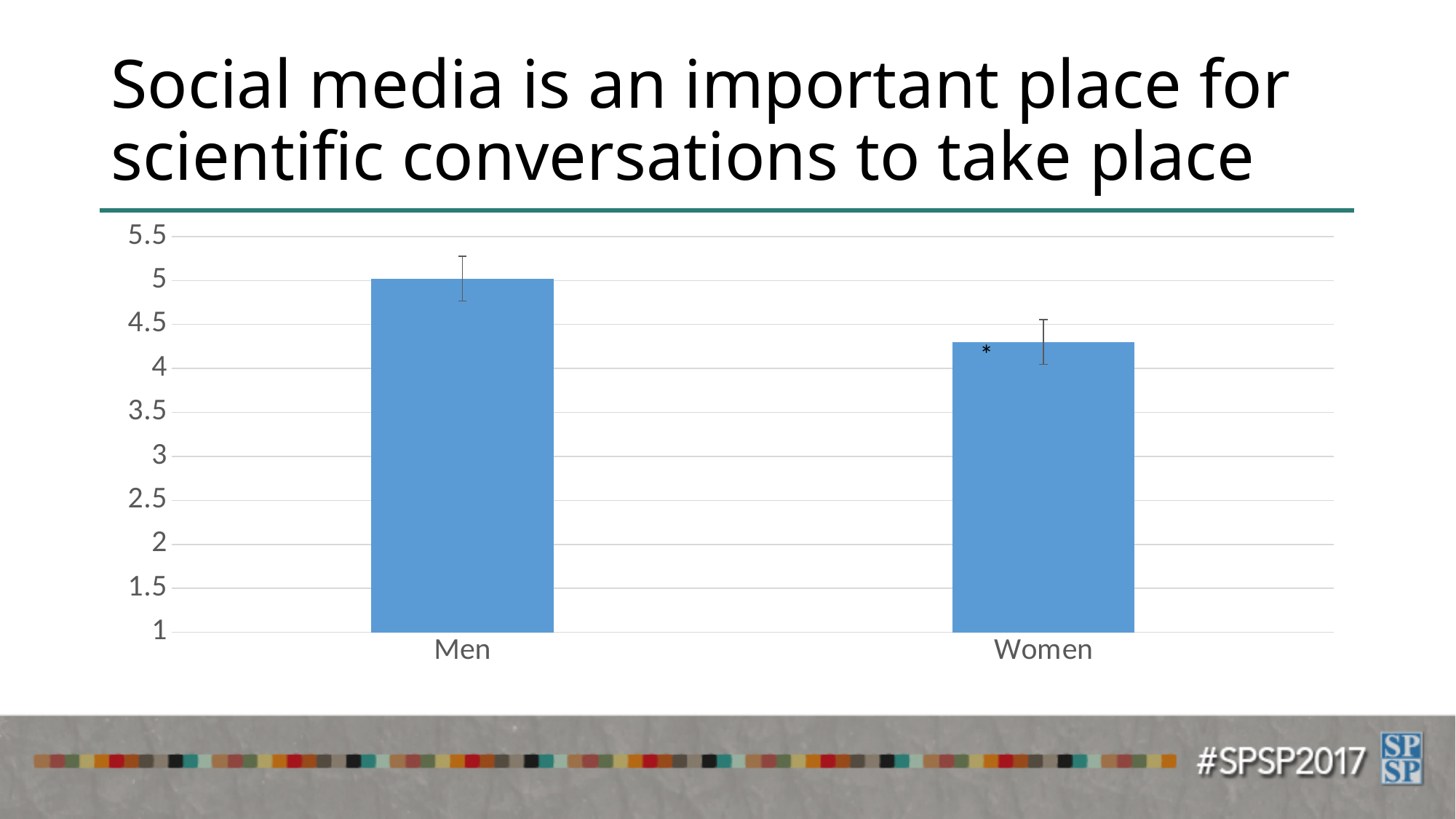
Is the value for Women greater or less than 4? greater Which category has the highest bar? Men What kind of chart is shown on the slide? Bar chart What is the highest tick value shown on the y axis? 5.5 Which bar is marked with an asterisk? Women Is the value for Men greater or less than 4.5? greater Which bar is taller, Men or Women? Men Is the value for Women greater or less than 4.5? less Which category has the lowest bar? Women How many categories are plotted on the x axis? 2